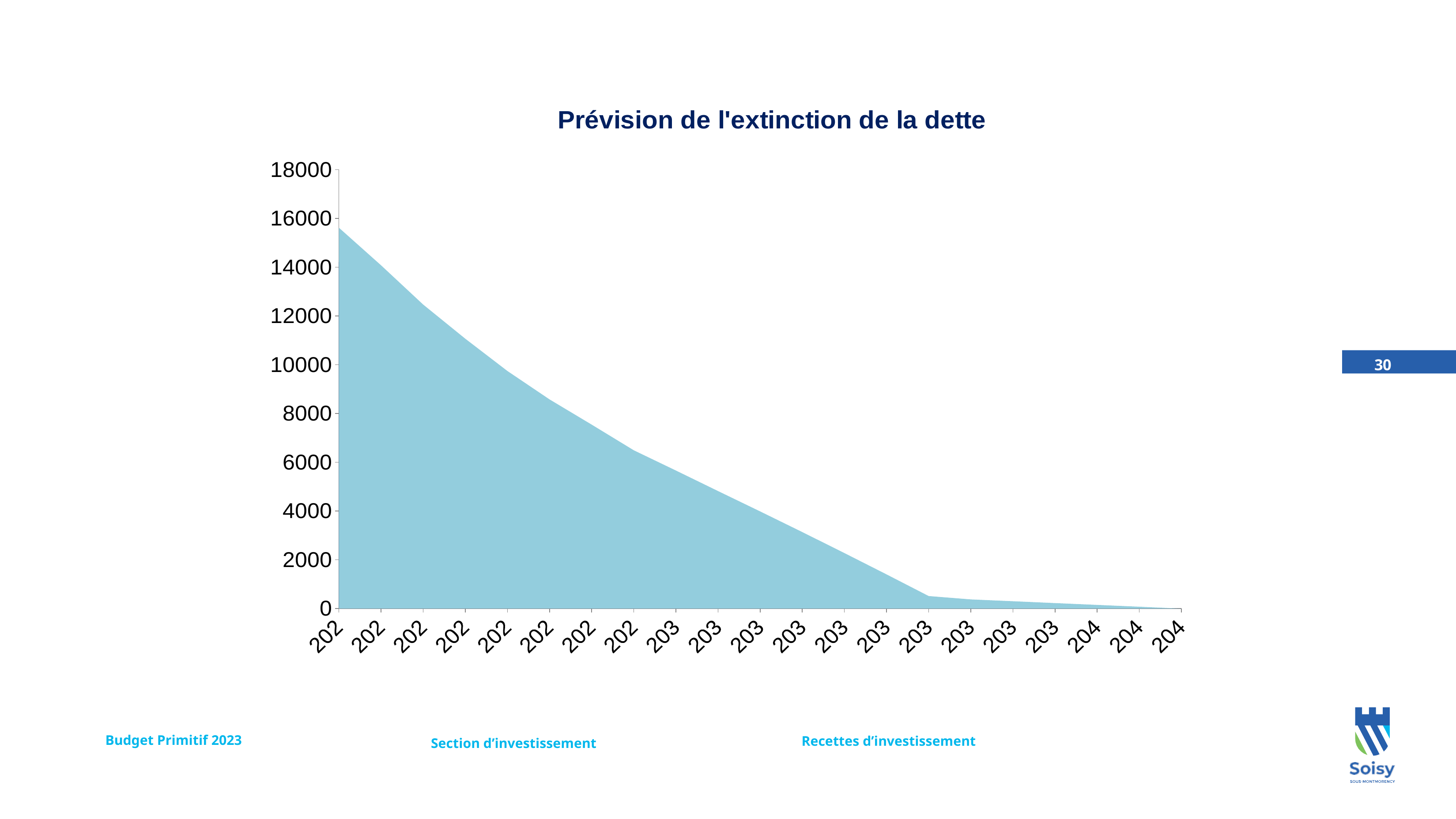
What is the highest tick value shown on the y axis? 18000 How many points are plotted along the x axis of the chart? 21 What kind of chart is shown on the slide? Area chart Is the value at the third point from the left larger or smaller than the value at the tenth point from the left? Larger Do the values rise or fall from left to right along the x axis? Fall Is the value at the fifth point from the left greater or less than 10000? less What is the title of the chart? Prévision de l'extinction de la dette Is the value at the fifteenth point from the left greater or less than 2000? less Is the value at the leftmost point of the chart greater or less than 14000? greater Which point on the chart has the highest value, the leftmost or the rightmost? The leftmost